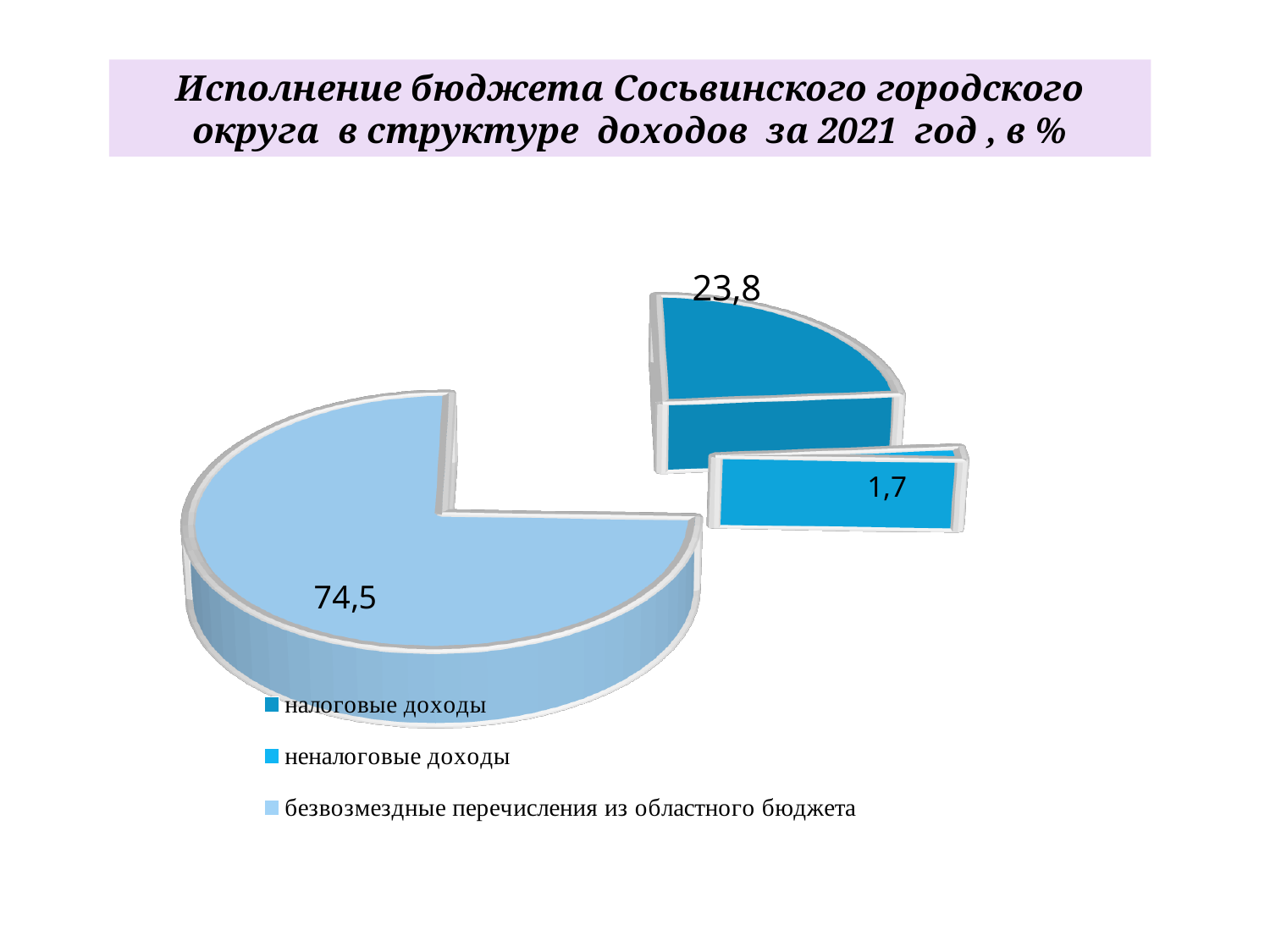
What is the value for безвозмездные перечисления из областного бюджета? 74,5 What is the difference between the values for налоговые доходы and неналоговые доходы? 22,1 What is the value for налоговые доходы? 23,8 Which is larger, налоговые доходы or неналоговые доходы? налоговые доходы How many slices does the pie chart have? 3 What year does the chart title say the data is for? 2021 What kind of chart is shown on the slide? pie chart Which category has the smallest slice of the pie? неналоговые доходы Which category has the largest slice of the pie? безвозмездные перечисления из областного бюджета How many entries does the legend list? 3 What is the value for неналоговые доходы? 1,7 What is the difference between the values for безвозмездные перечисления из областного бюджета and налоговые доходы? 50,7